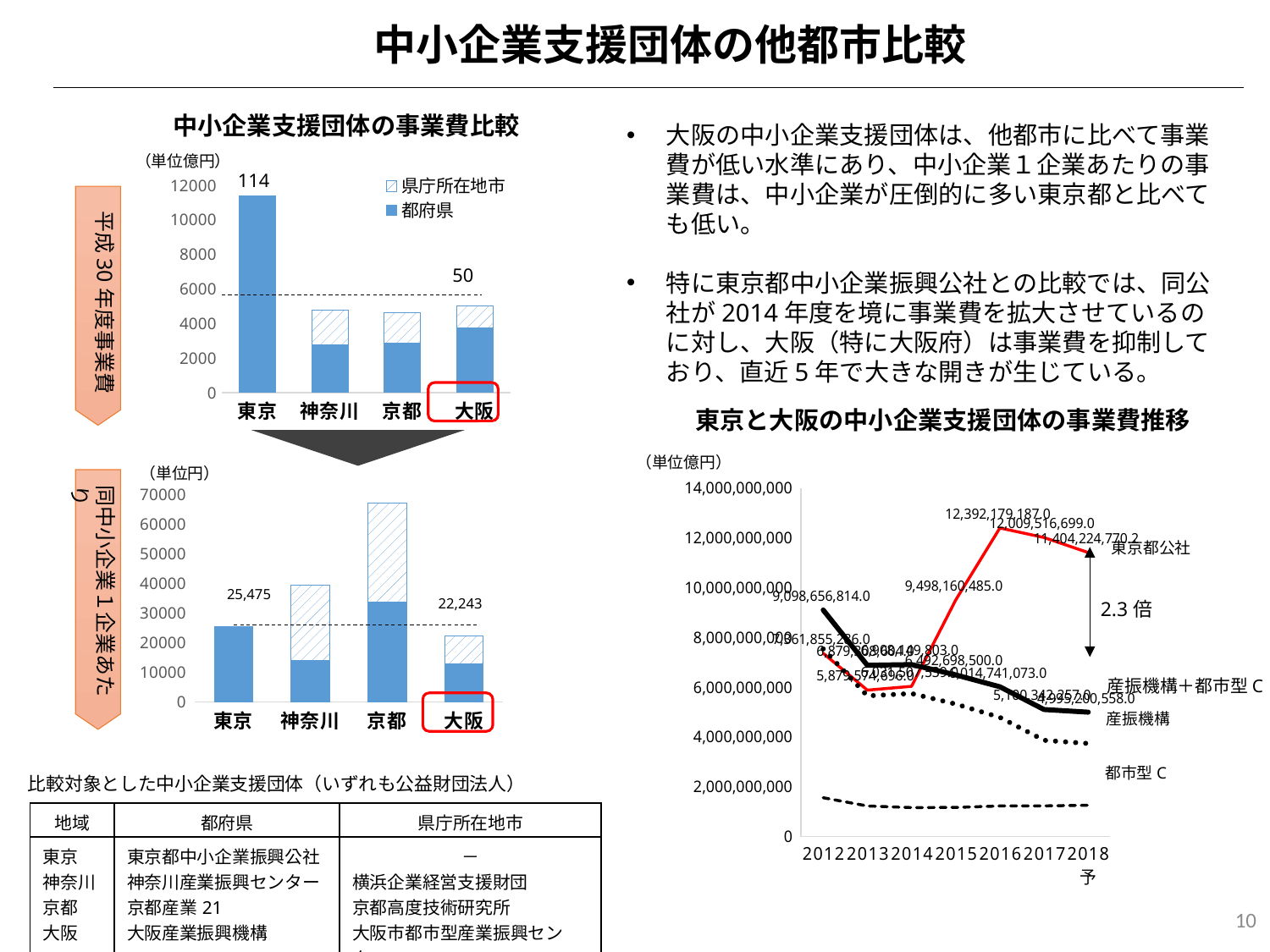
In the top-left chart (平成30年度事業費), what value is labelled above the 大阪 bar? 50 What kind of chart is the top-left chart titled 中小企業支援団体の事業費比較? bar chart In the top-left chart (平成30年度事業費), what value is labelled above the 東京 bar? 114 In the top-left chart (平成30年度事業費), which category has the tallest bar? 東京 In the bottom-left chart (同中小企業1企業あたり), which category has the tallest bar? 京都 In the right chart (東京と大阪の中小企業支援団体の事業費推移), which series is lowest in 2018予? 都市型C In the top-left chart (平成30年度事業費), is the total bar for 神奈川 greater or less than 6000? less In the bottom-left chart (同中小企業1企業あたり), what is the difference between the labelled values for 東京 and 大阪? 3,232 In the bottom-left chart (同中小企業1企業あたり), what value is labelled for 東京? 25,475 In the top-left chart (平成30年度事業費), how many series does the legend list? 2 In the bottom-left chart (同中小企業1企業あたり), what value is labelled for 大阪? 22,243 In the right chart (東京と大阪の中小企業支援団体の事業費推移), what is the labelled value for 東京都公社 in 2016? 12,392,179,187.0